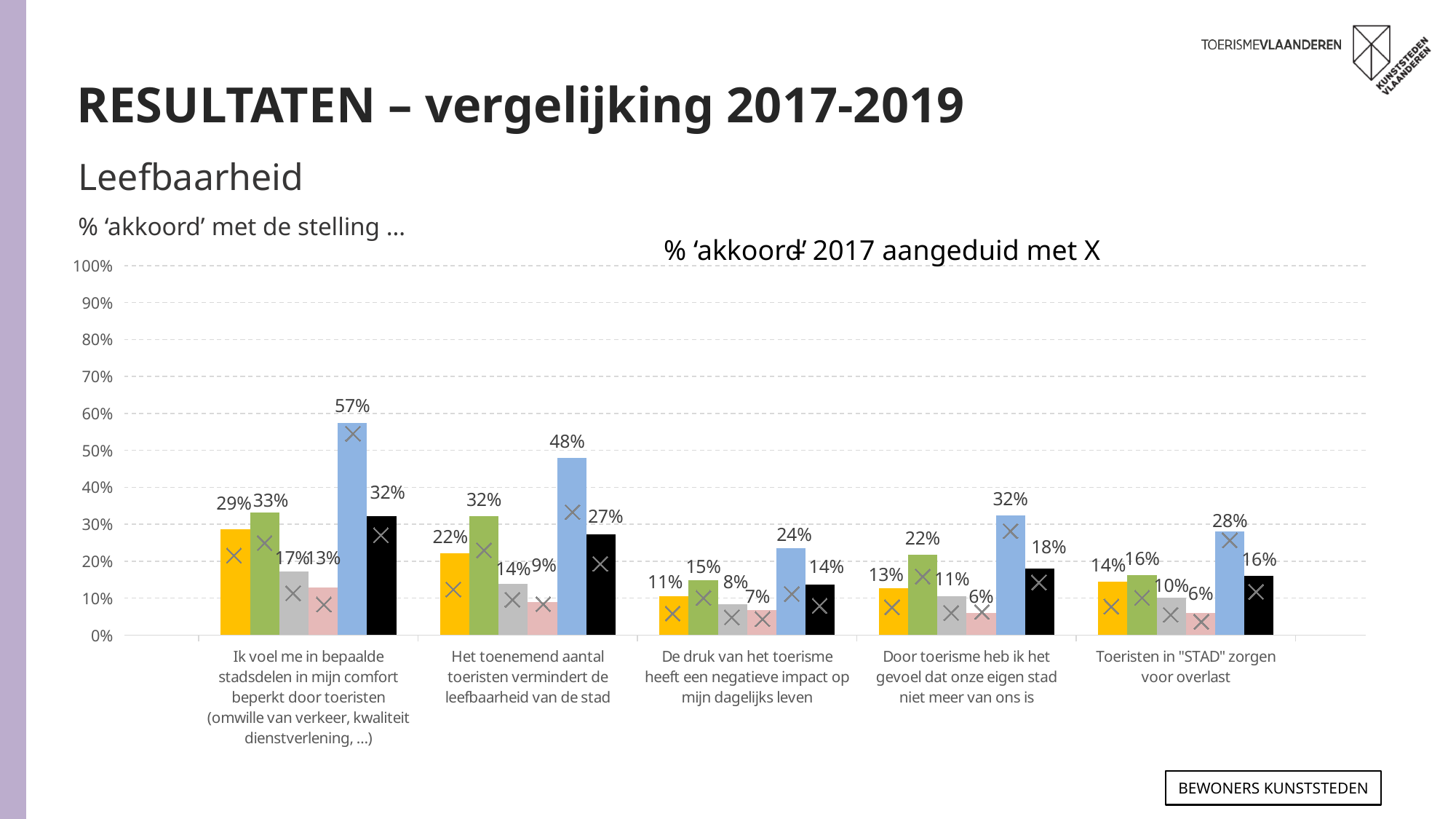
What is the difference between the blue bar and the black bar for the statement "Het toenemend aantal toeristen vermindert de leefbaarheid van de stad"? 21% What is the value of the green bar for the statement "Het toenemend aantal toeristen vermindert de leefbaarheid van de stad"? 32% What is the value of the blue bar for the statement "Toeristen in "STAD" zorgen voor overlast"? 28% According to the text on the chart, what do the X markers indicate? % 'akkoord' 2017 Which statement has the highest blue bar? Ik voel me in bepaalde stadsdelen in mijn comfort beperkt door toeristen (omwille van verkeer, kwaliteit dienstverlening, ...) How many statements (categories) are shown on the x axis of the chart? 5 For the statement "De druk van het toerisme heeft een negatieve impact op mijn dagelijks leven", which is larger: the green bar or the black bar? the green bar How many bars are shown for each statement in the chart? 6 What type of chart is shown on the slide? bar chart What is the value of the black bar for the statement "Door toerisme heb ik het gevoel dat onze eigen stad niet meer van ons is"? 18% Is the value of the blue bar for the statement "Ik voel me in bepaalde stadsdelen in mijn comfort beperkt door toeristen" greater or less than 50%? greater Which statement has the lowest blue bar? De druk van het toerisme heeft een negatieve impact op mijn dagelijks leven